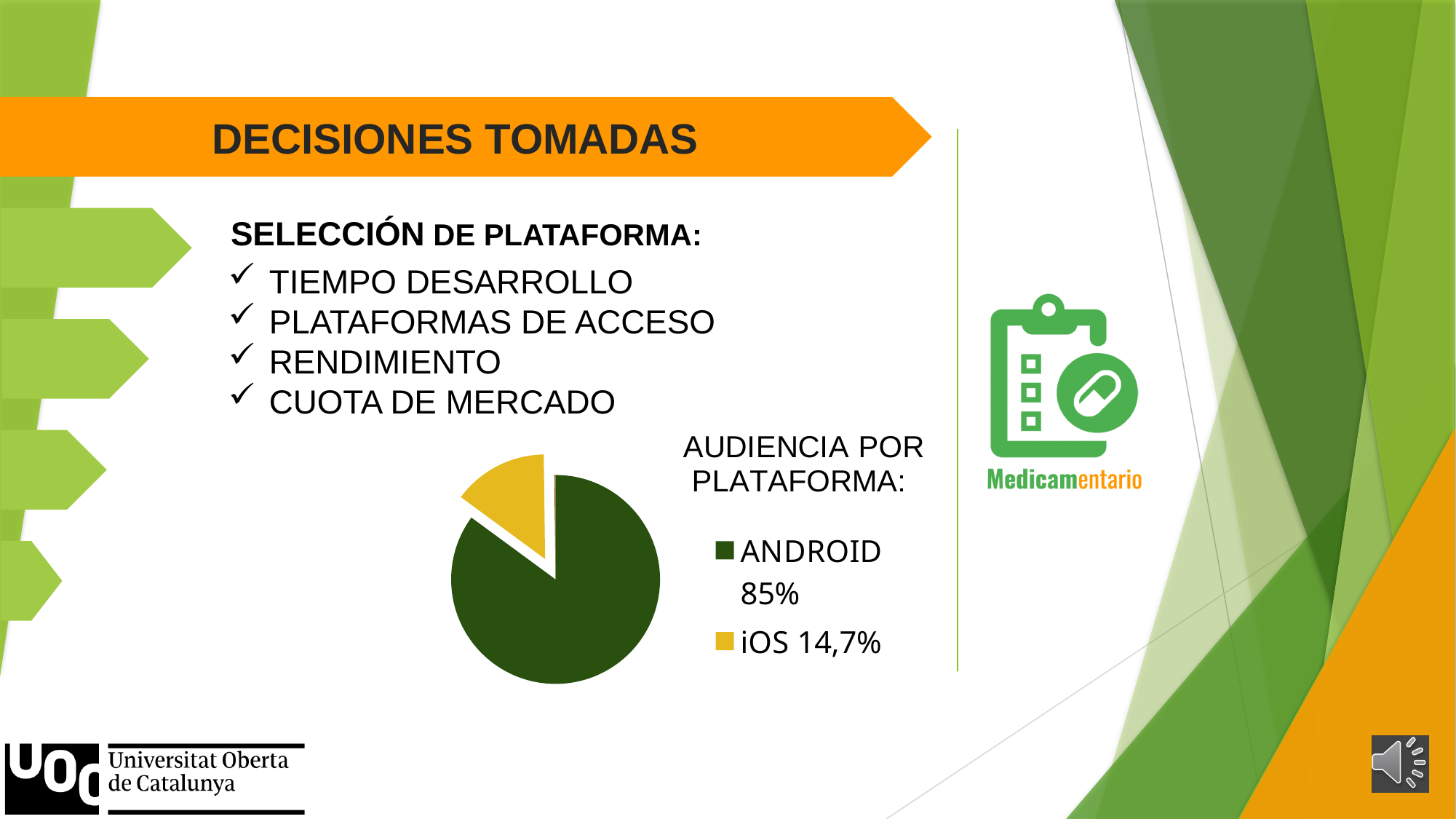
What share of the audience does ANDROID have according to the chart? 85% What share of the audience does iOS have according to the chart? 14,7% Which platform has the largest slice in the pie chart? ANDROID How many entries does the chart legend list? 2 Which is larger in the pie chart, ANDROID or iOS? ANDROID What kind of chart is shown on the slide? pie chart Is the value for iOS in the chart greater or less than 50%? less What colour is the ANDROID slice in the pie chart? dark green What is the difference between the ANDROID and iOS shares in the chart? 70,3% What is the title of the chart on the slide? AUDIENCIA POR PLATAFORMA: